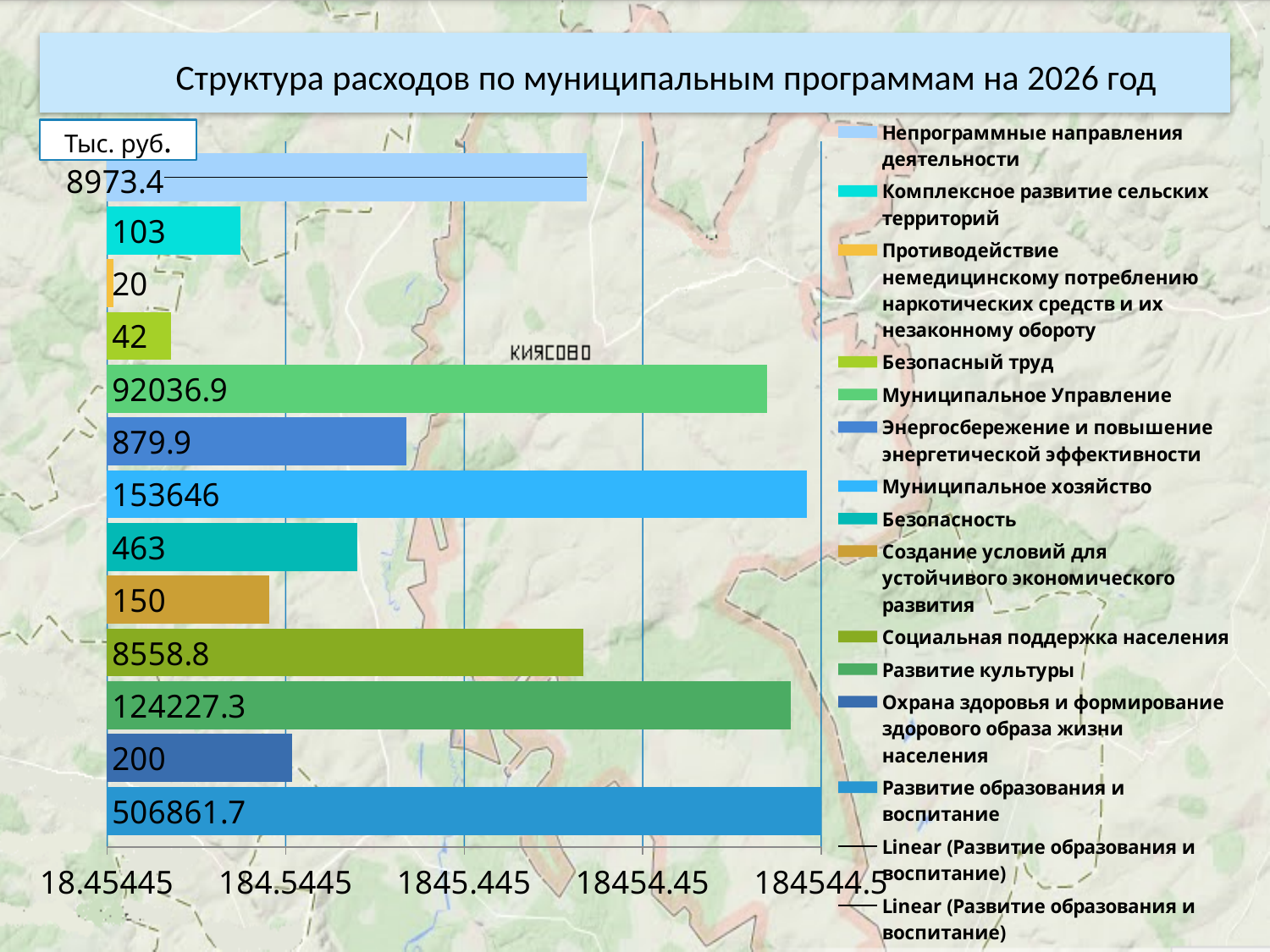
What is the difference between the values for Муниципальное хозяйство and Развитие культуры? 29418.7 Which category has the lowest value? Противодействие немедицинскому потреблению наркотических средств и их незаконному обороту What is the value for Развитие культуры? 124227.3 Which category has the highest value? Развитие образования и воспитание What unit is indicated in the box above the chart? Тыс. руб. What is the value for Развитие образования и воспитание? 506861.7 What kind of chart is shown on the slide? Bar chart What is the value for Муниципальное хозяйство? 153646 How many bars are plotted in the chart? 13 Which is larger, the value for Муниципальное Управление or the value for Социальная поддержка населения? Муниципальное Управление What is the title of the chart? Структура расходов по муниципальным программам на 2026 год What is the value for Безопасный труд? 42